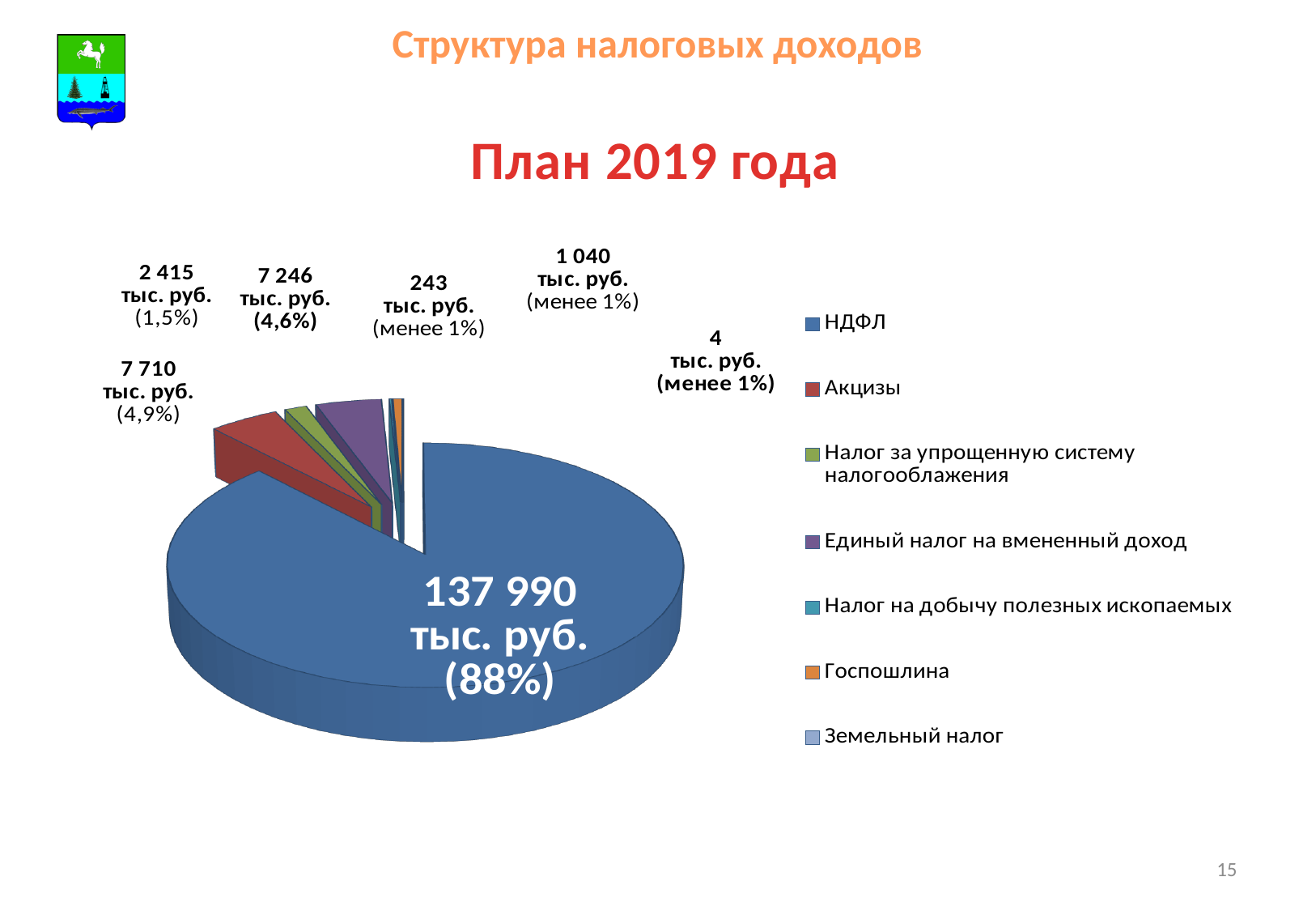
What kind of chart is shown on the slide? pie chart What share of the pie does НДФЛ account for? 88% How many categories does the legend of the pie chart list? 7 What is the planned value for Налог за упрощенную систему налогообложения? 2 415 тыс. руб. What is the planned value for Акцизы in the pie chart? 7 710 тыс. руб. What is the planned value for Единый налог на вмененный доход? 7 246 тыс. руб. Which is larger, the value for Акцизы or the value for Единый налог на вмененный доход? Акцизы Which year's plan does the pie chart show, according to the heading above it? 2019 What is the planned value for НДФЛ in the pie chart? 137 990 тыс. руб. What share of the pie does Акцизы account for? 4,9% What is the difference between the value for НДФЛ and the value for Акцизы? 130 280 тыс. руб. Which category has the largest slice of the pie chart? НДФЛ